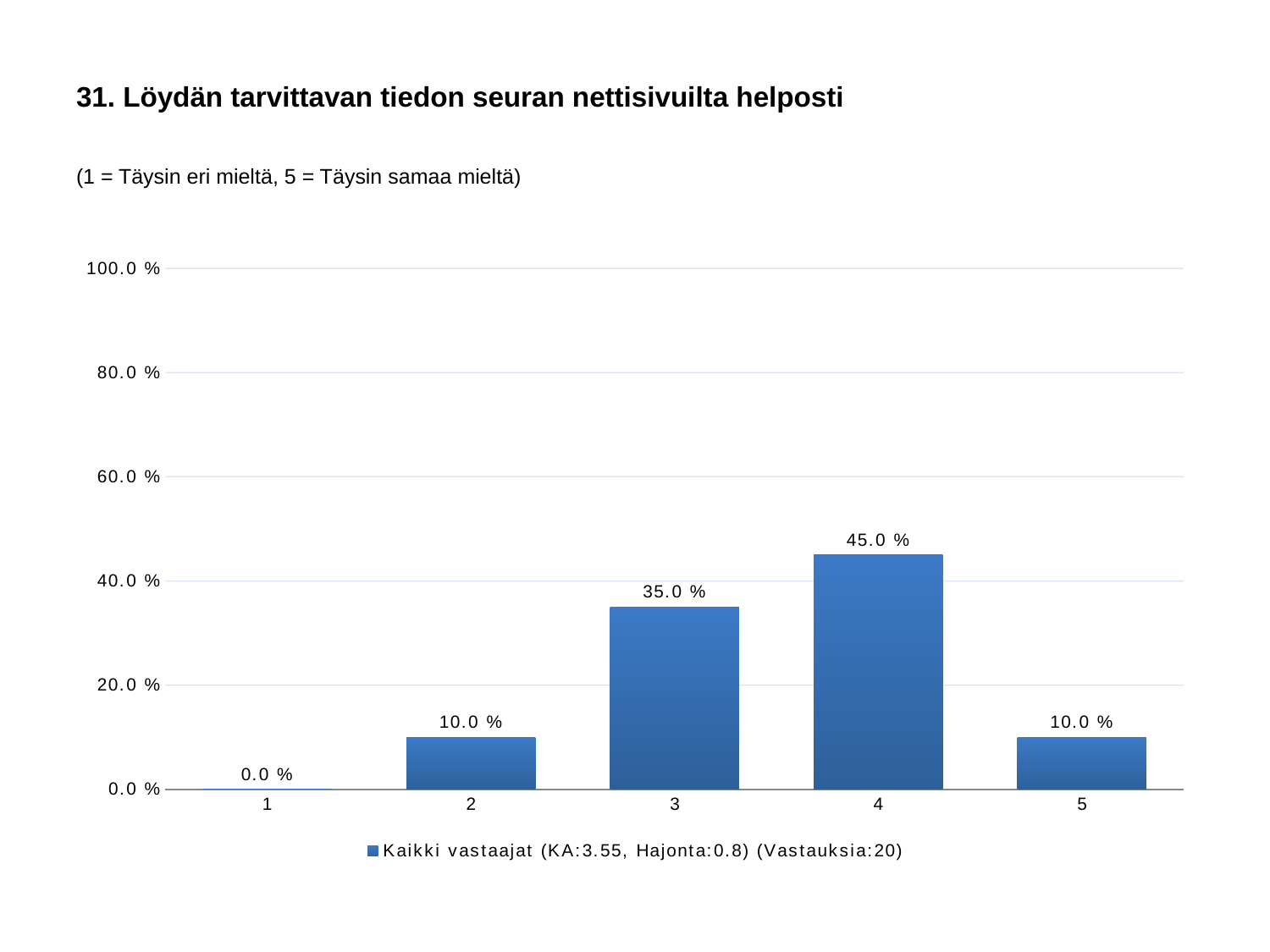
What kind of chart is shown? bar chart What is the value for category 1? 0.0 % Which category has the lowest value? 1 What is the legend entry for the series? Kaikki vastaajat (KA:3.55, Hajonta:0.8) (Vastauksia:20) Which category has the highest value? 4 Is the value for category 4 greater or less than 40.0 %? greater What is the value for category 4? 45.0 % How many categories are shown on the x axis? 5 How many series does the legend list? 1 What is the value for category 3? 35.0 % Which is larger, the value for category 2 or the value for category 3? 3 What is the difference between the values for category 4 and category 3? 10.0 %